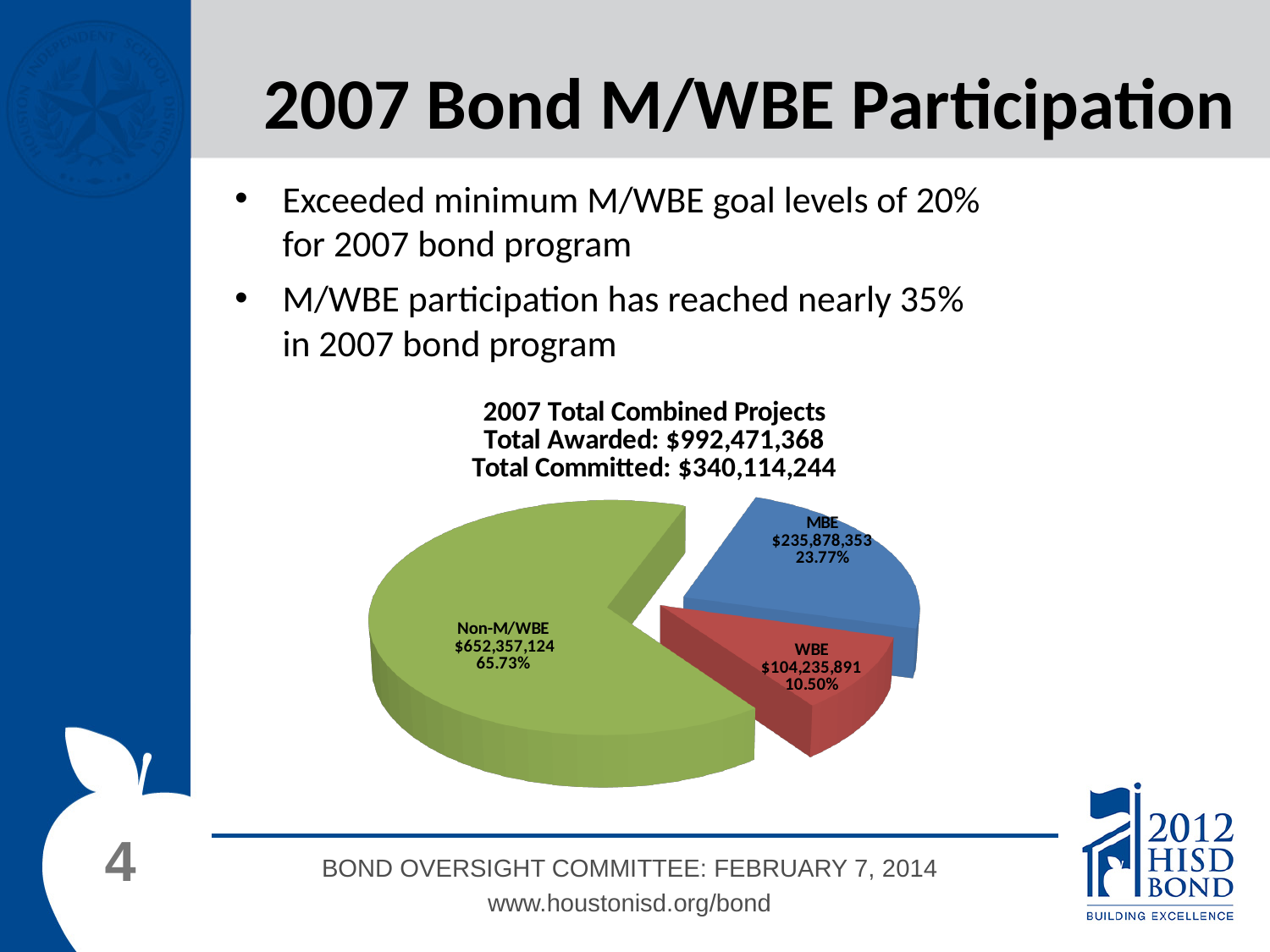
What is the dollar value of the Non-M/WBE slice? $652,357,124 What share of the pie does the MBE slice represent? 23.77% What is the dollar value of the MBE slice? $235,878,353 What Total Awarded amount is stated in the chart title? $992,471,368 What is the dollar value of the WBE slice? $104,235,891 How many slices does the pie chart have? 3 Which category has the largest slice of the pie? Non-M/WBE What share of the pie does the WBE slice represent? 10.50% What type of chart is shown on the slide? Pie chart Which is larger, the MBE slice or the WBE slice? MBE What is the difference in dollars between the MBE and WBE slices? $131,642,462 Which category has the smallest slice of the pie? WBE